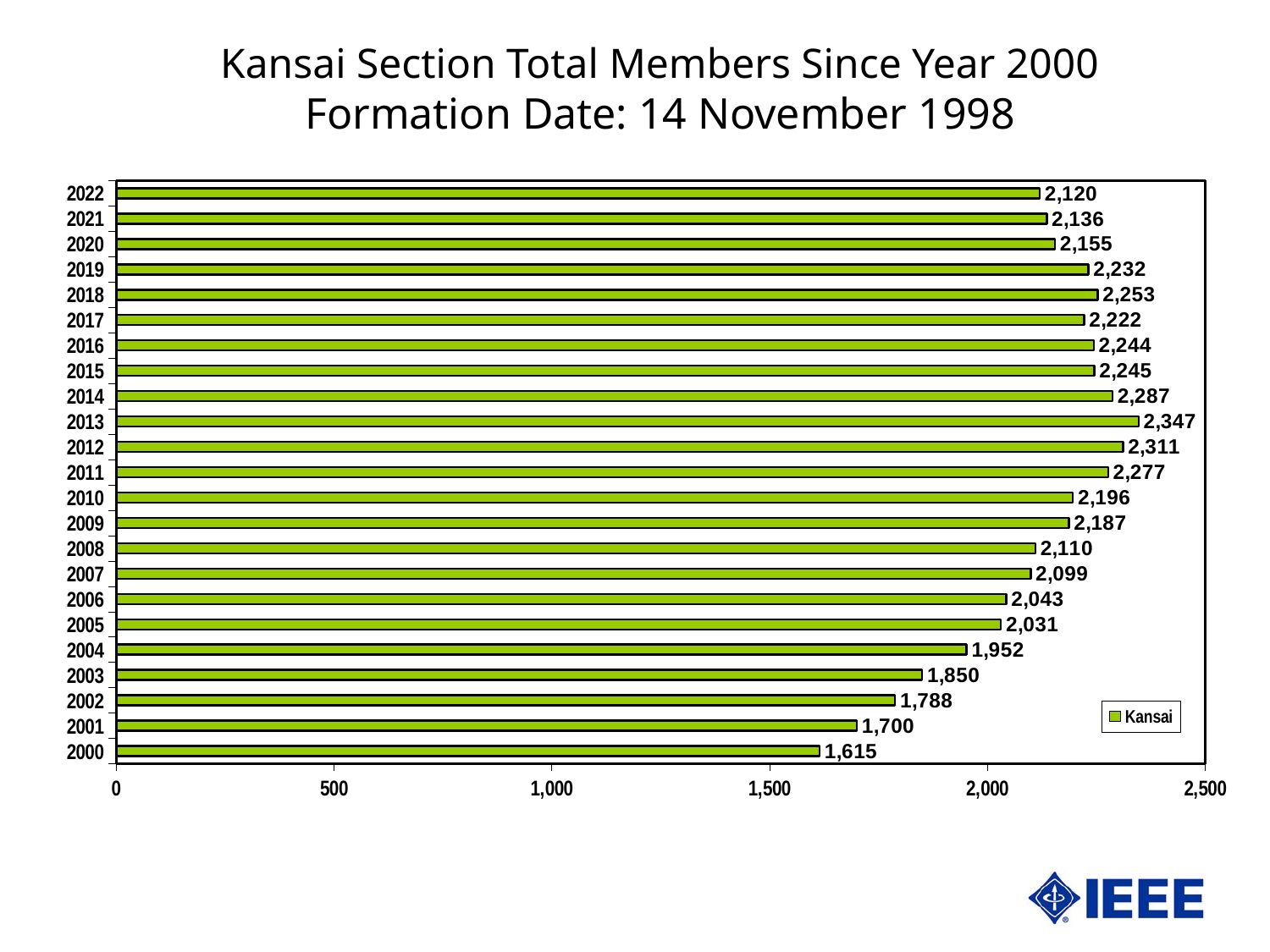
What is the total number of Kansai Section members in 2000? 1,615 What series name is listed in the chart legend? Kansai Which year has the highest number of members? 2013 Which year had more members, 2004 or 2010? 2010 What is the total number of Kansai Section members in 2013? 2,347 What kind of chart is shown on the slide? bar chart What is the difference in members between 2022 and 2021? 16 What is the difference in members between 2013 and 2000? 732 Which year has the lowest number of members? 2000 How many years are shown in the chart? 23 What is the total number of Kansai Section members in 2022? 2,120 Is the value for 2003 greater or less than 2,000? less